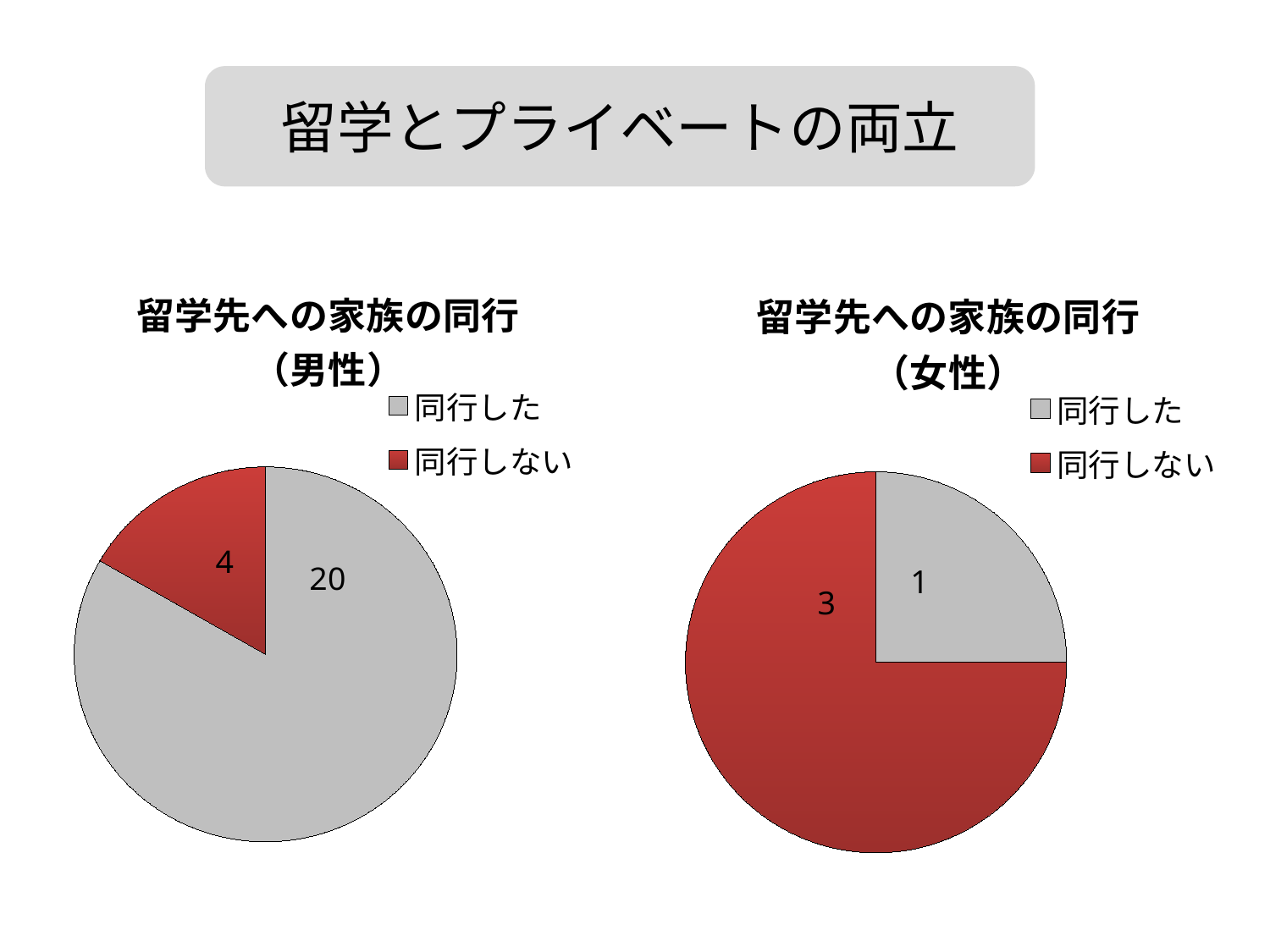
What kind of chart is the left chart (留学先への家族の同行（男性）)? pie chart In the right chart (留学先への家族の同行（女性）), which category has the smallest slice? 同行した In the right chart (留学先への家族の同行（女性）), what is the value for 同行した? 1 In the right chart (留学先への家族の同行（女性）), what share of the pie does 同行しない represent? 3/4 In the left chart (留学先への家族の同行（男性）), what is the difference between 同行した and 同行しない? 16 How many categories does the legend of the right chart (留学先への家族の同行（女性）) list? 2 In the right chart (留学先への家族の同行（女性）), which is larger, 同行した or 同行しない? 同行しない In the left chart (留学先への家族の同行（男性）), what is the value for 同行しない? 4 In the right chart (留学先への家族の同行（女性）), what is the value for 同行しない? 3 In the left chart (留学先への家族の同行（男性）), what share of the pie does 同行しない represent? 1/6 In the left chart (留学先への家族の同行（男性）), which category has the largest slice? 同行した In the left chart (留学先への家族の同行（男性）), what is the value for 同行した? 20